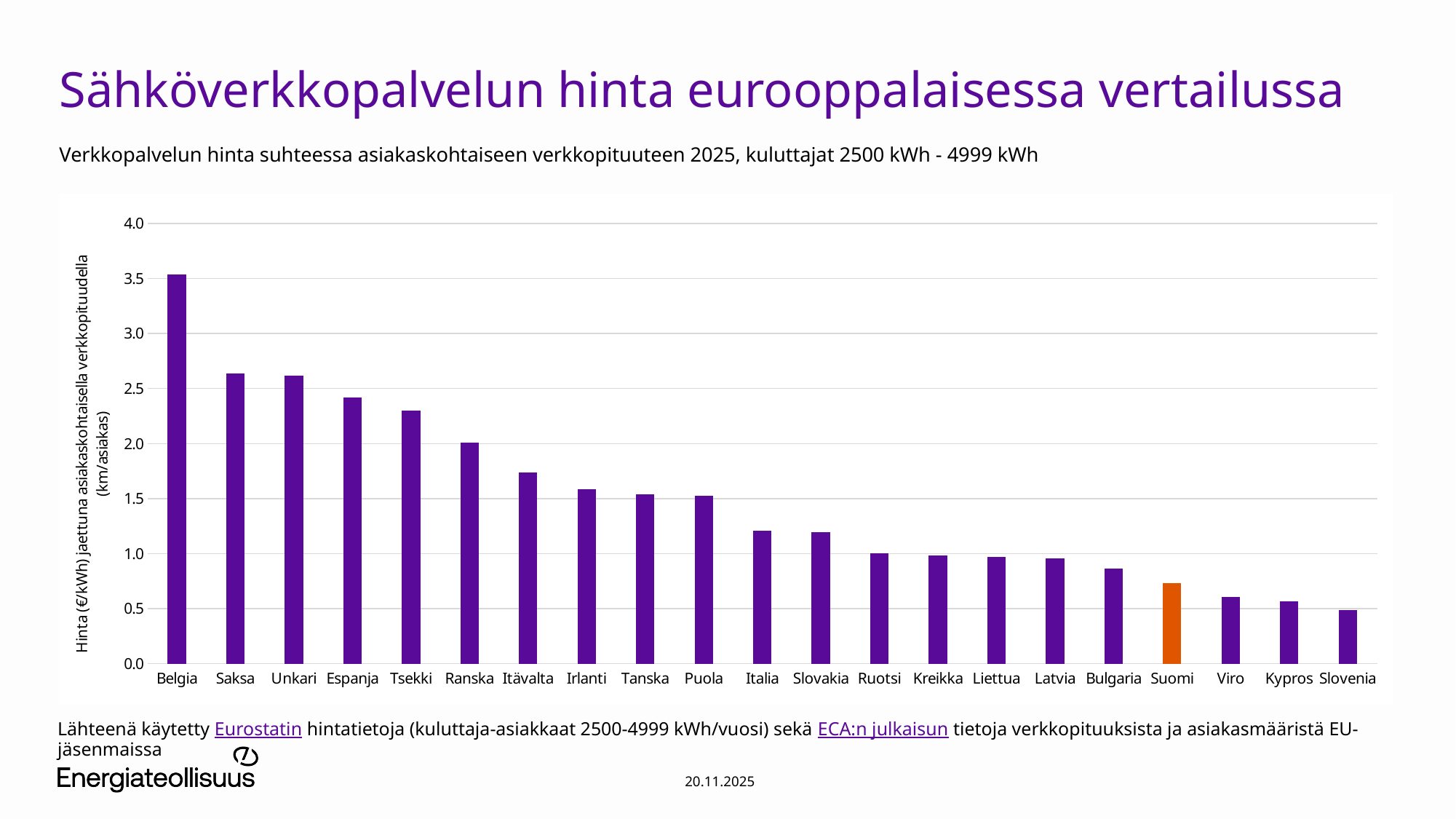
Do the values rise or fall from left to right along the x axis? fall Is the value for Itävalta greater or less than 1.5? greater Which has a larger value, Saksa or Tsekki? Saksa Is the value for Belgia greater or less than 3.0? greater Is the value for Espanja greater or less than 2.5? less How many countries are shown in the chart? 21 Which country has the lowest value in the chart? Slovenia What kind of chart is shown on the slide? bar chart Which country's bar is coloured orange instead of purple? Suomi Which country has the highest value in the chart? Belgia Which has a larger value, Suomi or Viro? Suomi